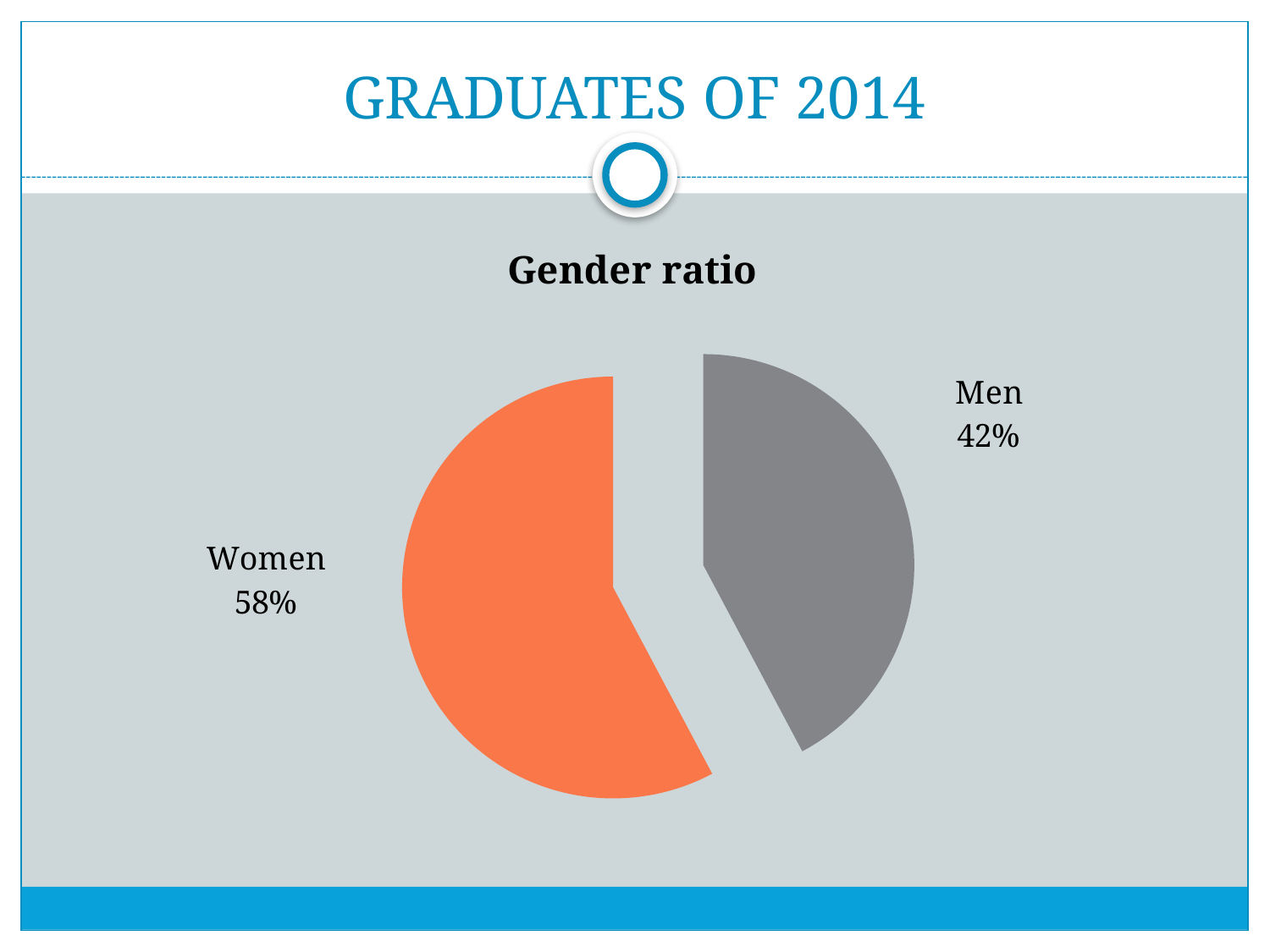
Which slice of the pie is the smallest? Men How many slices does the pie chart have? 2 What is the title of the chart? Gender ratio Is the value for Men greater or less than 50%? less What kind of chart is shown on the slide? pie chart Which is larger, the Women slice or the Men slice? Women What is the difference in percentage points between the Women and Men slices? 16 What share of the pie is Men? 42% What share of the pie is Women? 58% What colour is the Women slice? orange Which slice of the pie is the largest? Women